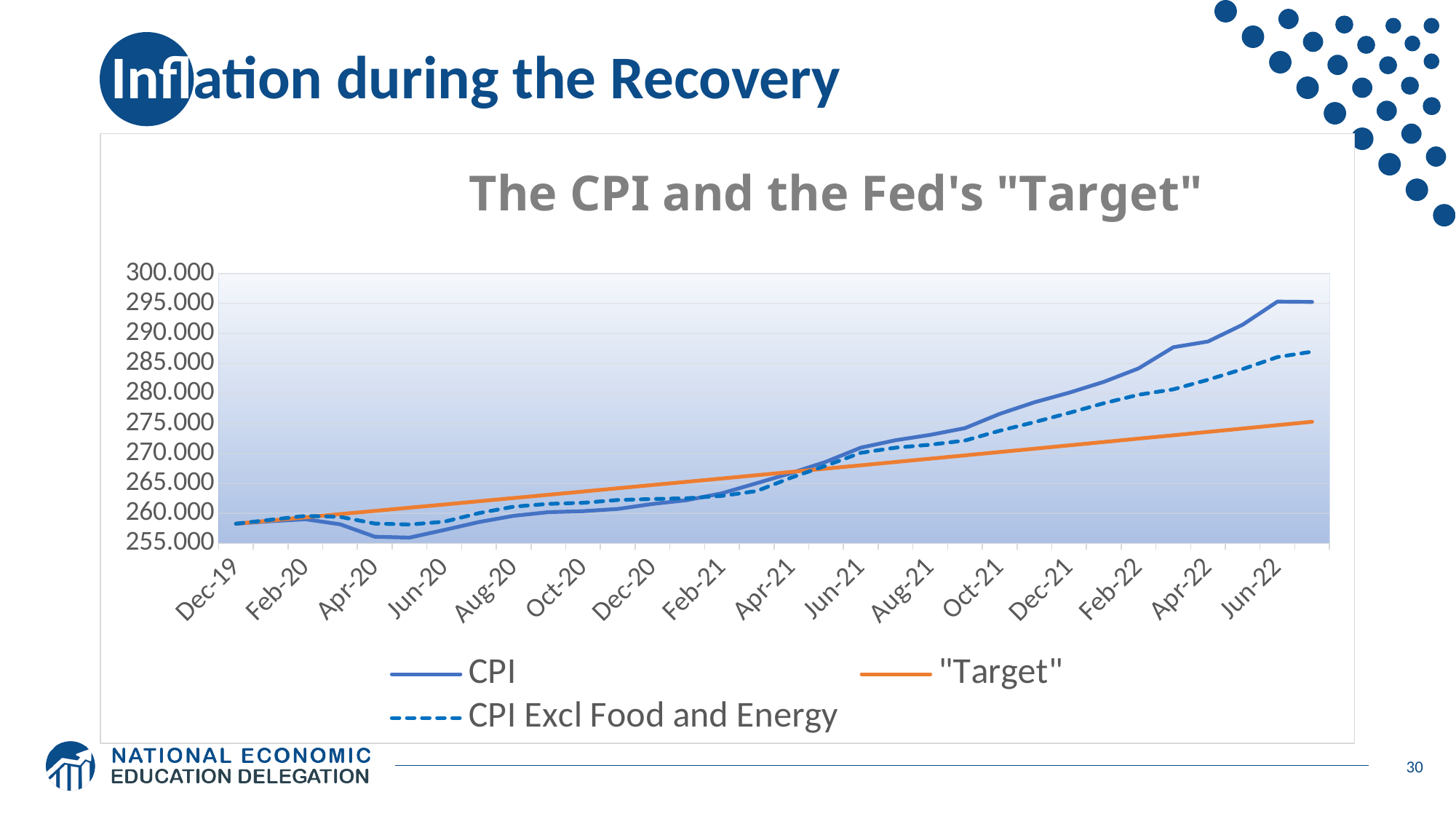
Is the value of the CPI series at Jun-22 greater or less than 290? greater Which series has the highest value at Jun-22? CPI Which series is drawn with a dashed line? CPI Excl Food and Energy Does the "Target" series rise or fall from Dec-19 to Jun-22? rise At Jun-20, which is larger: the CPI series or the "Target" series? "Target" How many series does the legend list? 3 Is the value of the "Target" series at Jun-22 greater or less than 280? less Is the value of the CPI series at Jun-20 greater or less than 260? less At Jun-22, which is larger: the CPI series or the "Target" series? CPI What kind of chart is shown on the slide? line chart What is the title of the chart? The CPI and the Fed's "Target"